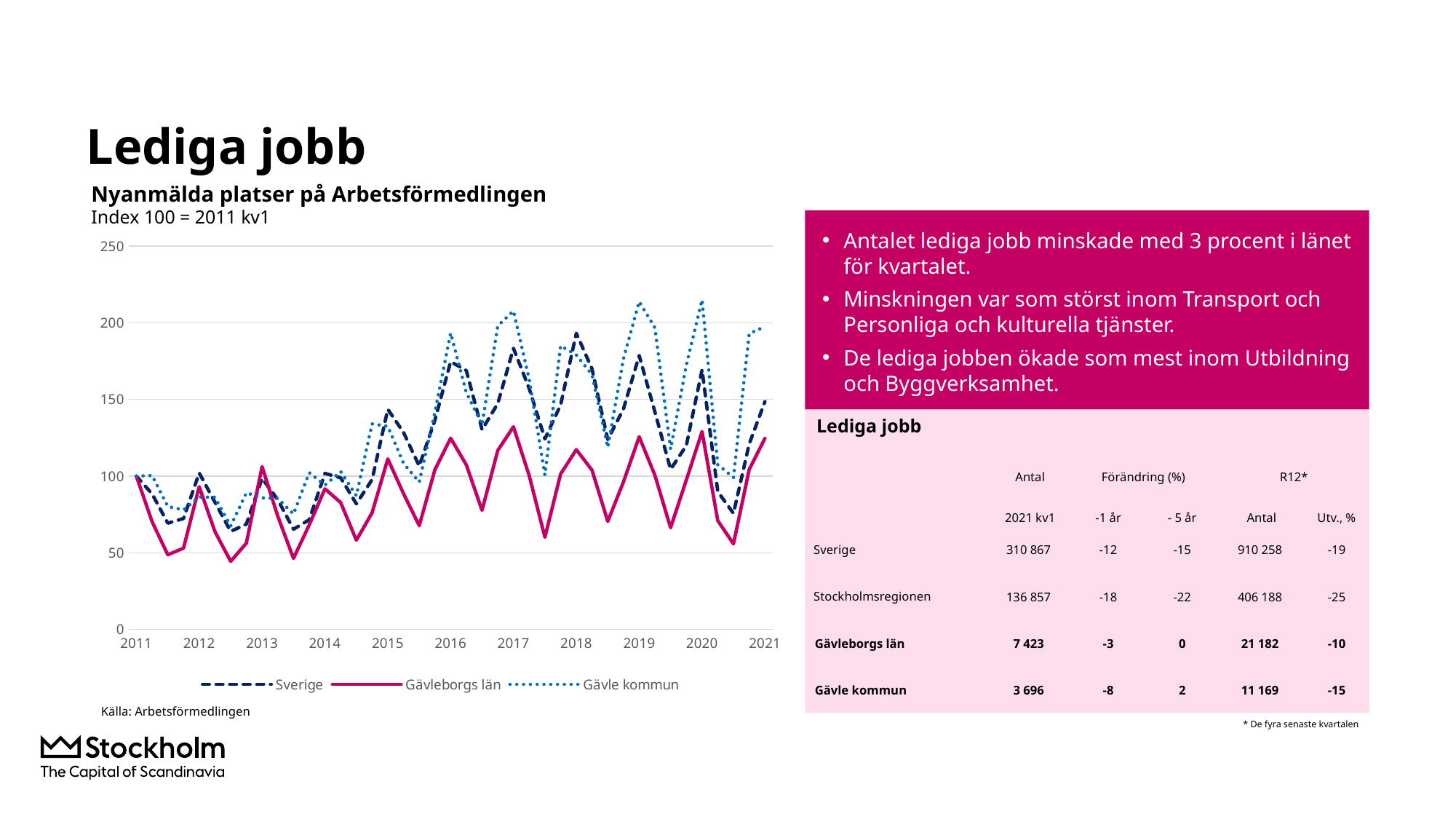
What is the index value of all three series at the start of the chart in 2011? 100 Which series are listed in the chart legend? Sverige, Gävleborgs län, Gävle kommun Is the peak value for Gävle kommun in 2019 greater or less than 200? greater What kind of chart is shown on the slide? Line chart What is the title of the chart? Nyanmälda platser på Arbetsförmedlingen Which series reaches the highest index value anywhere on the chart? Gävle kommun Which series reaches the lowest index value anywhere on the chart? Gävleborgs län Does the Gävle kommun series end in 2021 higher or lower than it started in 2011? Higher How many series does the chart legend list? 3 Is the highest value for Gävleborgs län in 2017 greater or less than 150? less Is the lowest value for Gävleborgs län in 2013 greater or less than 50? less How many year labels are shown on the x axis of the chart? 11